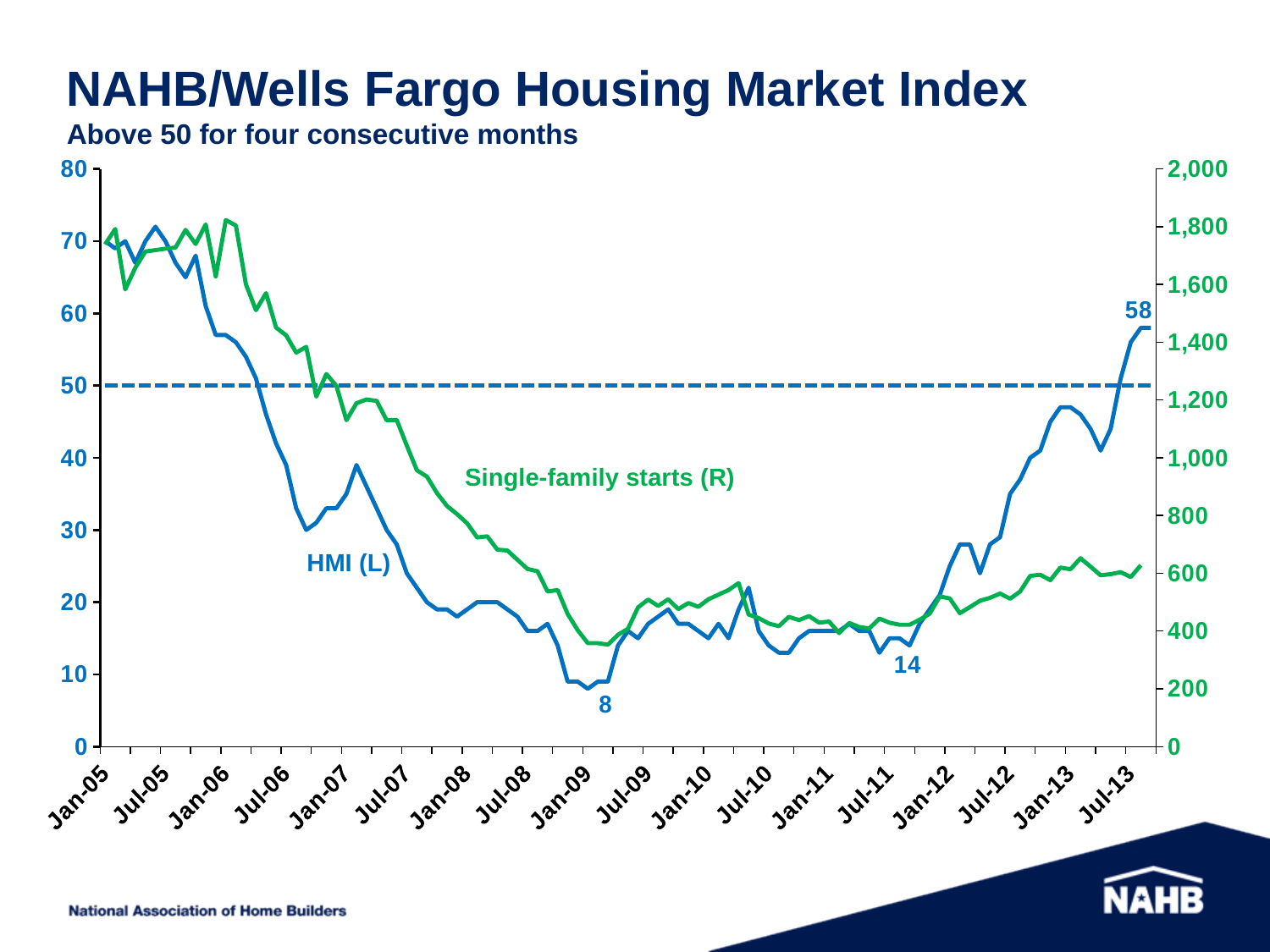
What is the latest labelled value of the HMI (L) series, at the right end of the chart? 58 Does the HMI (L) series rise or fall between Jan-12 and Jul-13? rise How many data series are plotted on the chart? 2 At what value on the left axis is the horizontal dashed line drawn? 50 Is the Single-family starts (R) value at Jan-05 greater or less than 1,400? greater What is the lowest labelled value of the HMI (L) series? 8 What is the difference between the latest HMI value (58) and the value labelled around Jul-11 (14)? 44 Is the Single-family starts (R) value at Jan-09 greater or less than 600? less What labelled value does the HMI (L) series reach around Jul-11? 14 What is the difference between the latest HMI value (58) and its lowest labelled value (8)? 50 Is the HMI (L) value at Jan-05 greater or less than 60? greater What kind of chart is shown on the slide? line chart